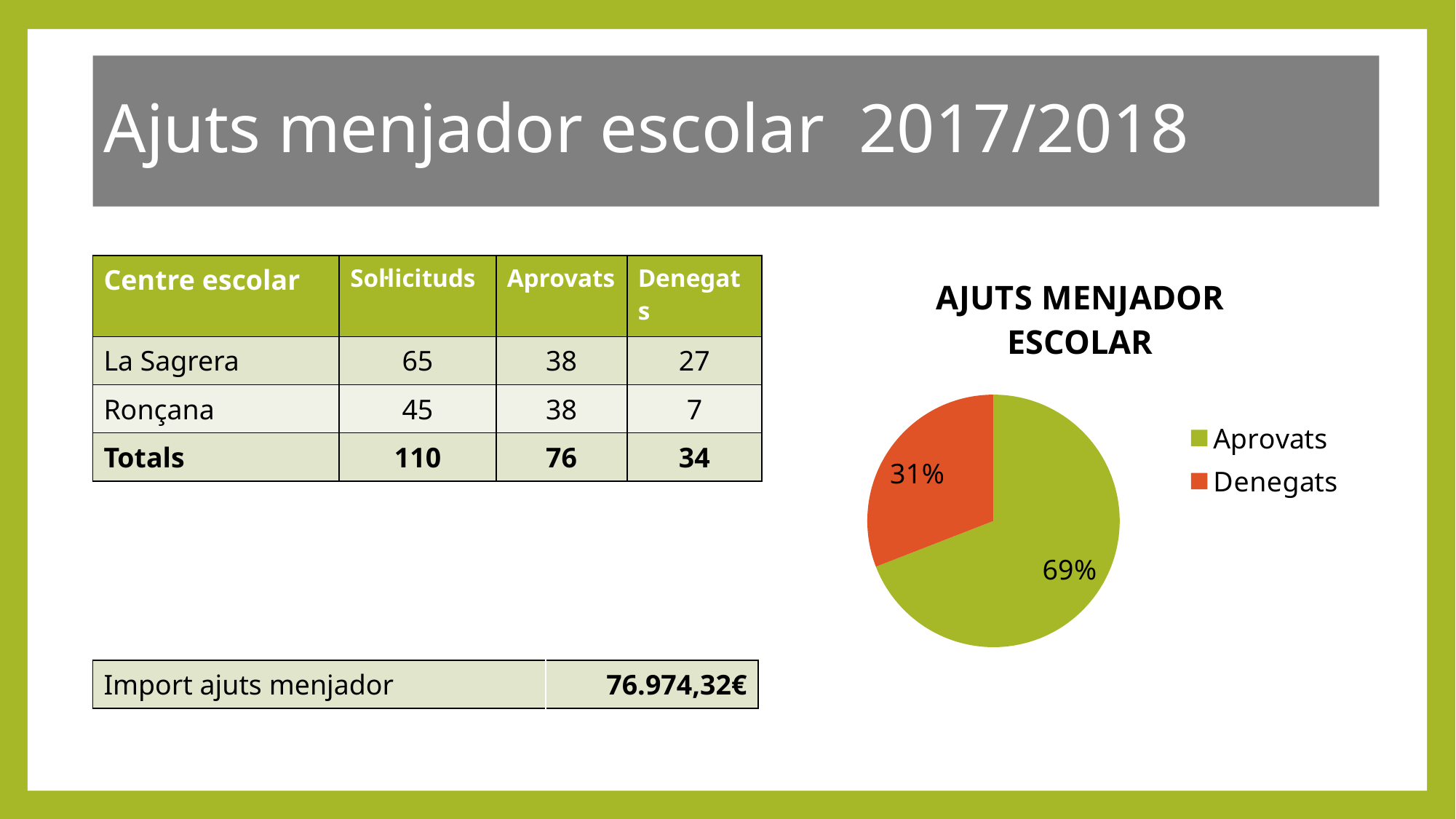
Which slice of the pie chart is the smallest? Denegats How many slices does the pie chart have? 2 Which slice of the pie chart is the largest? Aprovats What is the title of the pie chart? AJUTS MENJADOR ESCOLAR How many entries does the pie chart legend list? 2 What kind of chart is shown on the slide? pie chart What is the difference in percentage points between the Aprovats and Denegats slices? 38 Is the share for Aprovats greater or less than 50%? greater What colour is the Denegats slice in the pie chart? orange What share of the pie chart is Aprovats? 69% What share of the pie chart is Denegats? 31% Which is larger in the pie chart, Aprovats or Denegats? Aprovats